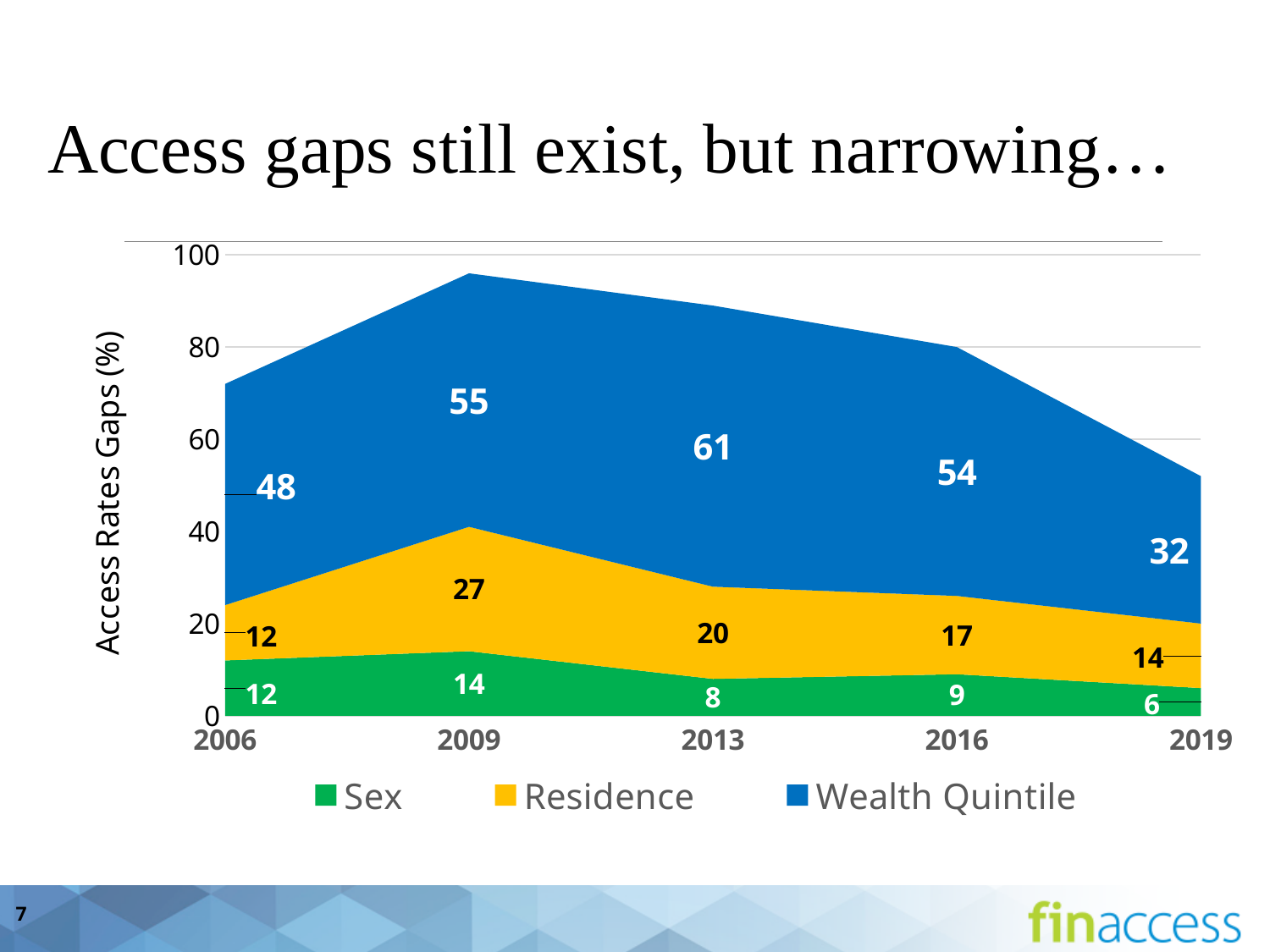
What is the y-axis label of the chart? Access Rates Gaps (%) What is the Wealth Quintile access gap value in 2013? 61 What kind of chart is shown on the slide? Stacked area chart What is the difference between the Wealth Quintile values in 2016 and 2019? 22 How many series does the legend list? 3 In which year is the Sex value lowest? 2019 What is the Sex value in 2019? 6 How many years are shown on the x axis? 5 What is the Residence value in 2009? 27 In which year is the Wealth Quintile value highest? 2013 What is the total of the three stacked values in 2019? 52 Which is larger in 2006, the Sex value or the Wealth Quintile value? Wealth Quintile